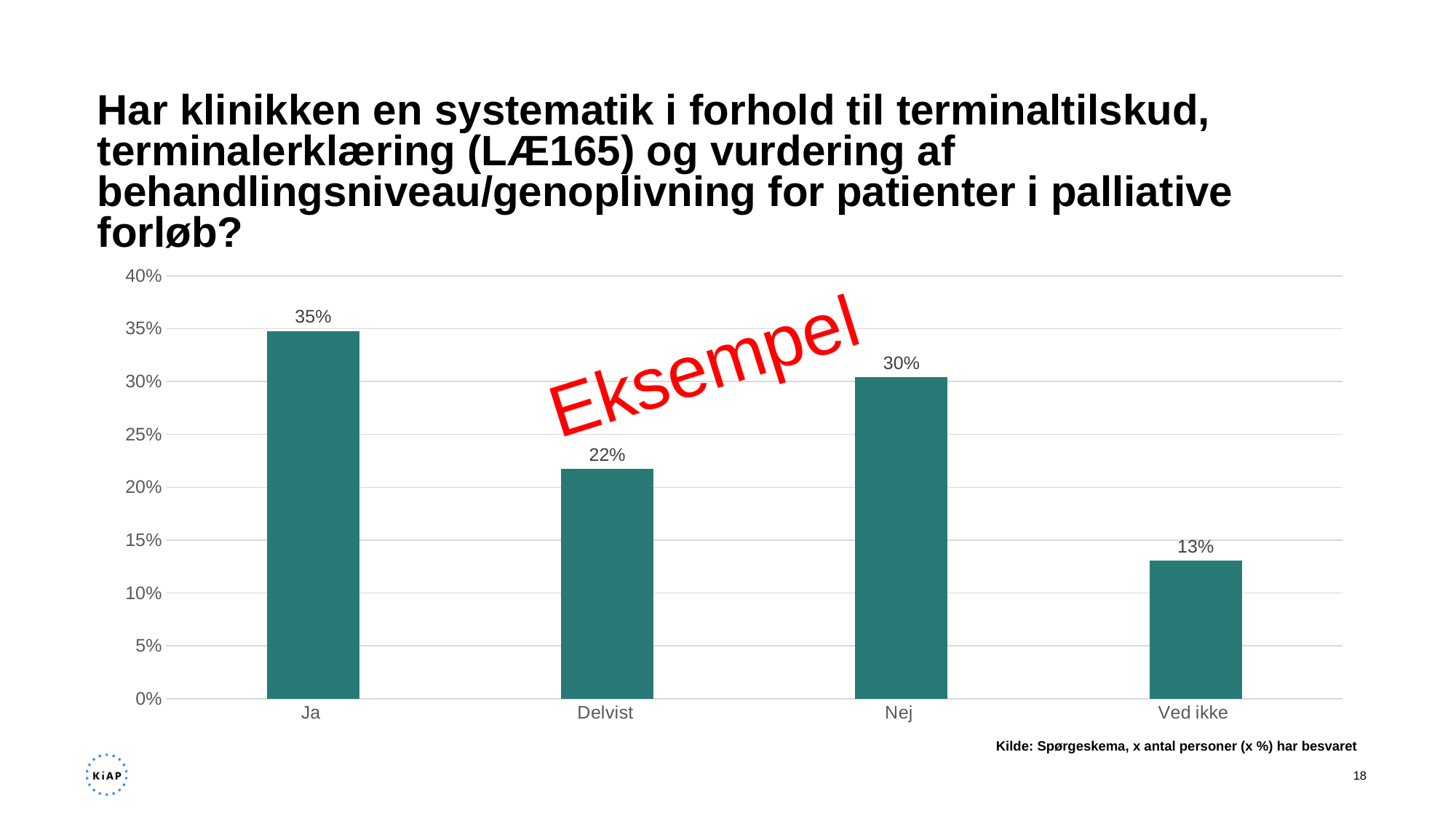
What is the value for Ja? 35% What is the difference between the values for Ja and Nej? 5% Is the value for Ved ikke greater or less than 15%? less Which category has the highest value? Ja What kind of chart is shown on the slide? bar chart What is the value for Ved ikke? 13% What is the value for Delvist? 22% Which is larger, the value for Delvist or the value for Nej? Nej How many categories are shown on the x axis? 4 What is the value for Nej? 30% Which category has the lowest value? Ved ikke What is the difference between the values for Delvist and Ved ikke? 9%